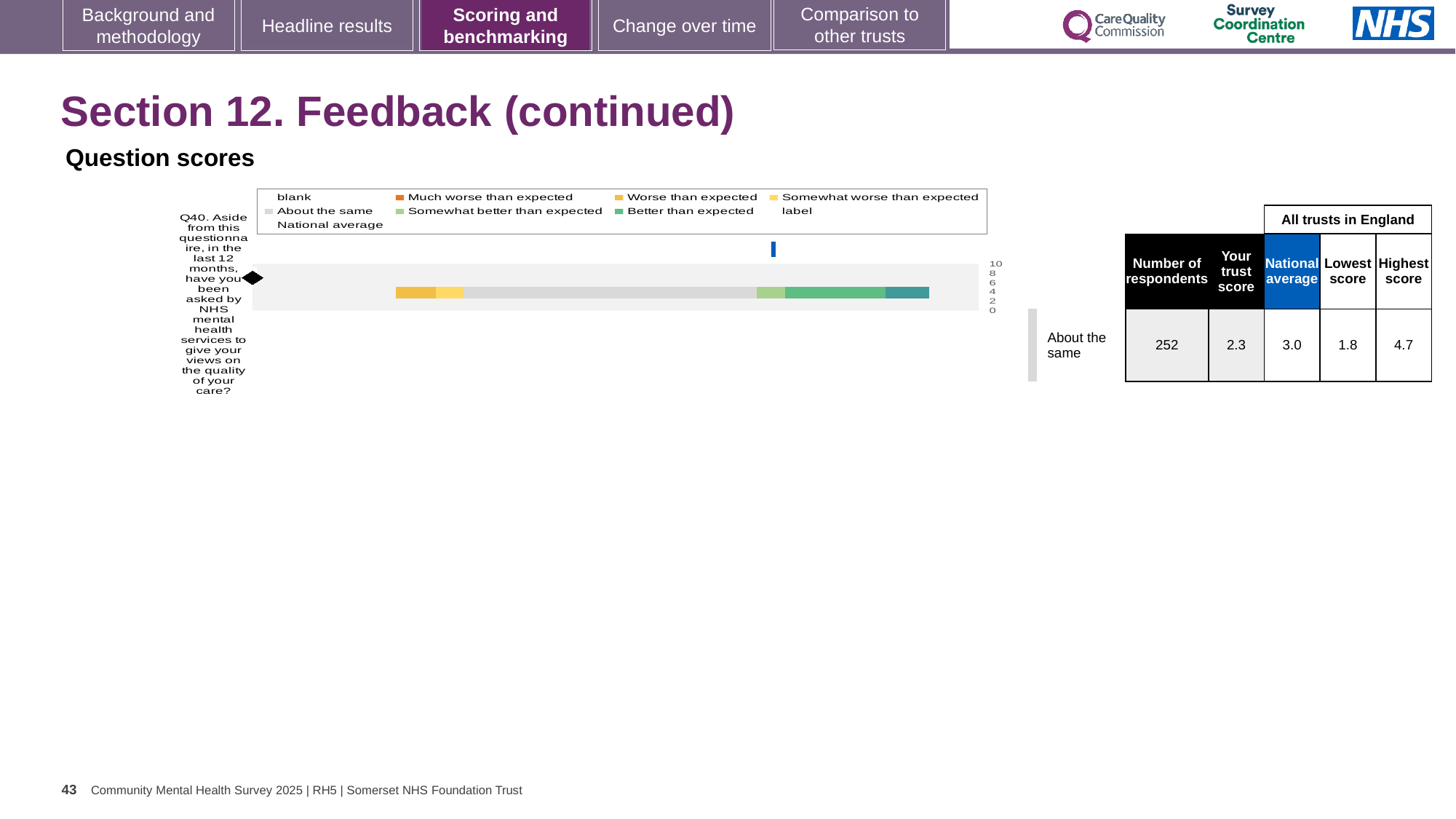
Which question is plotted in the chart? Q40. Aside from this questionnaire, in the last 12 months, have you been asked by NHS mental health services to give your views on the quality of your care? How many questions (categories) are plotted in the chart? 1 What kind of chart is shown on the slide? bar chart Which is larger for Q40, the trust score or the national average? national average What is the highest score among all trusts in England for Q40? 4.7 What is the lowest score among all trusts in England for Q40? 1.8 What is the maximum value shown on the chart's axis? 10 How is the trust's Q40 score categorised relative to expectations? About the same What is the national average for Q40? 3.0 How many respondents answered Q40? 252 What is the difference between the national average and the trust score for Q40? 0.7 What is the trust score for Q40? 2.3